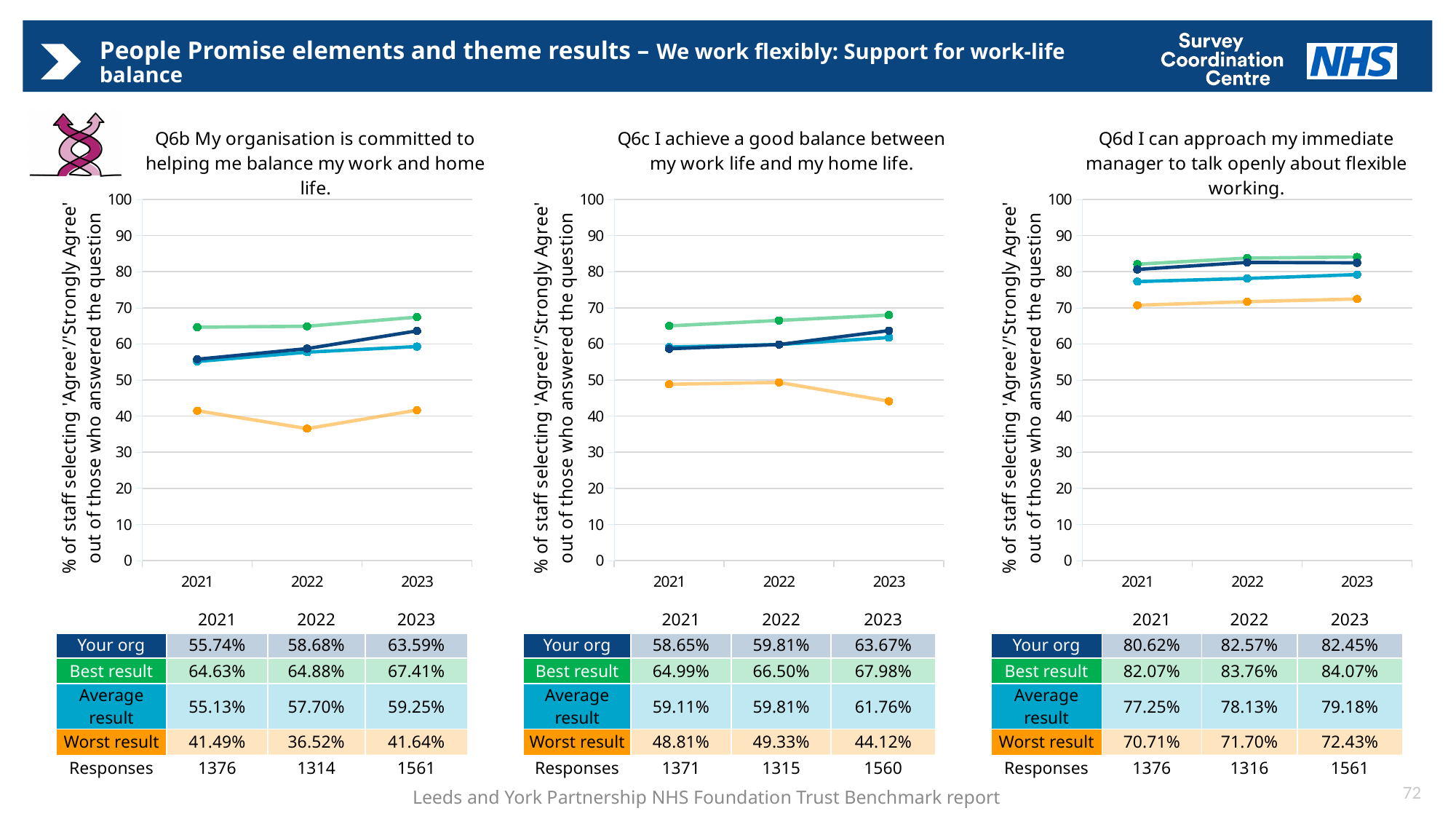
How many years are plotted on the x axis of the Q6d chart? 3 What type of chart is used for Q6b? Line chart In the Q6c chart, what is the difference between the 'Best result' and 'Your org' values in 2023? 4.31% In the Q6c chart, what was the 'Worst result' value in 2022? 49.33% In the Q6d chart, what was the 'Best result' value in 2021? 82.07% In the Q6b chart, which year had the lowest 'Worst result' value? 2022 In the Q6d chart, which year had the highest 'Your org' value? 2022 In the Q6b chart, what was the 'Your org' value in 2023? 63.59% In the Q6c chart, does the 'Your org' line rise or fall from 2021 to 2023? Rise In the Q6c chart, is the 'Worst result' value for 2023 greater or less than 50? less In the Q6d chart, how many responses were recorded in 2023? 1561 In the Q6b chart, which was larger in 2022: 'Your org' or 'Average result'? Your org